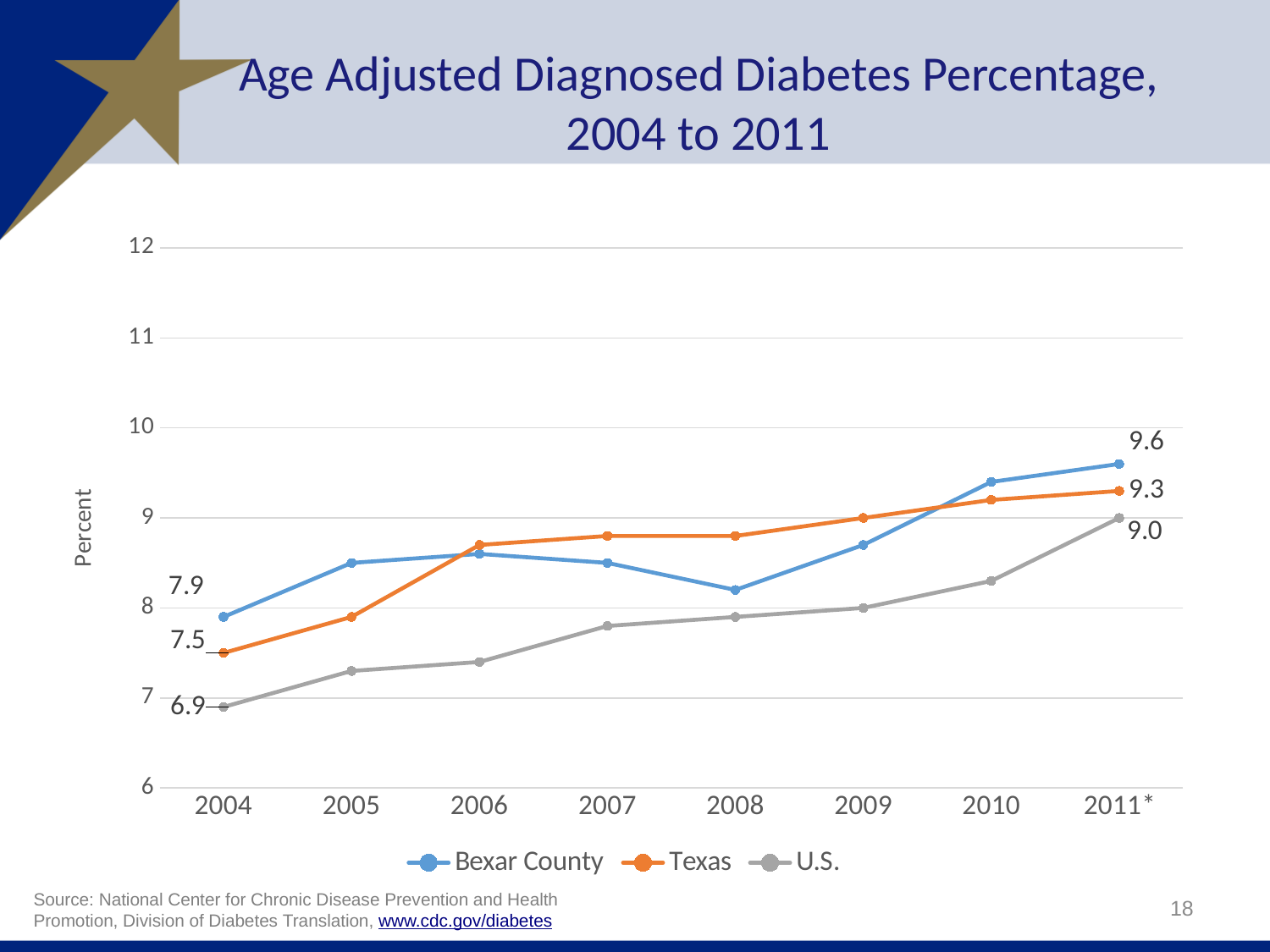
What is the difference between the Bexar County and Texas values in 2011*? 0.3 Which series has the highest value in 2011*? Bexar County What is the value for U.S. in 2011*? 9.0 What kind of chart is shown on the slide? Line chart By how much did the Bexar County value increase from 2004 to 2011*? 1.7 Which series has the lowest value in 2004? U.S. What is the value for U.S. in 2004? 6.9 How many series does the legend list? 3 Is the value for Bexar County in 2008 greater or less than 9? less What is the value for Texas in 2011*? 9.3 Which is larger in 2004, the Texas value or the U.S. value? Texas What is the value for Bexar County in 2004? 7.9